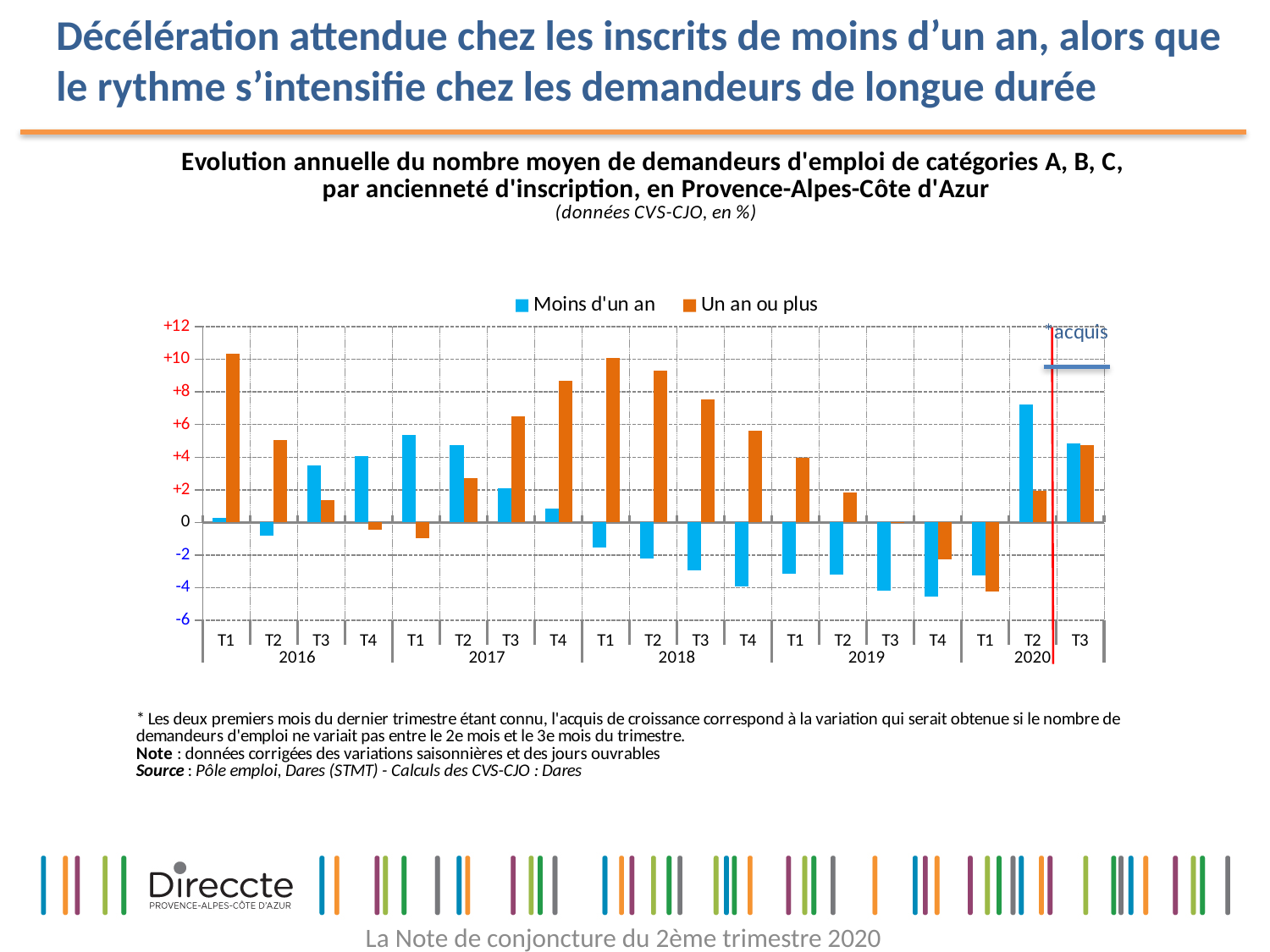
How many quarters are plotted along the x axis? 19 How many series does the legend list? 2 Do the values for 'Un an ou plus' rise or fall from T1 2018 to T1 2020? fall Is the value for 'Moins d'un an' in T2 2020 greater or less than +6? greater Is the value for 'Un an ou plus' in T1 2016 greater or less than +8? greater In which quarter is the value for 'Moins d'un an' the highest? T2 2020 In which quarter is the value for 'Un an ou plus' the lowest? T1 2020 In T1 2017, which series has the larger value, 'Moins d'un an' or 'Un an ou plus'? Moins d'un an What kind of chart is shown on the slide? bar chart In T1 2016, which series has the larger value, 'Moins d'un an' or 'Un an ou plus'? Un an ou plus What are the two series named in the legend? Moins d'un an; Un an ou plus Is the value for 'Moins d'un an' in T4 2019 greater or less than -4? less